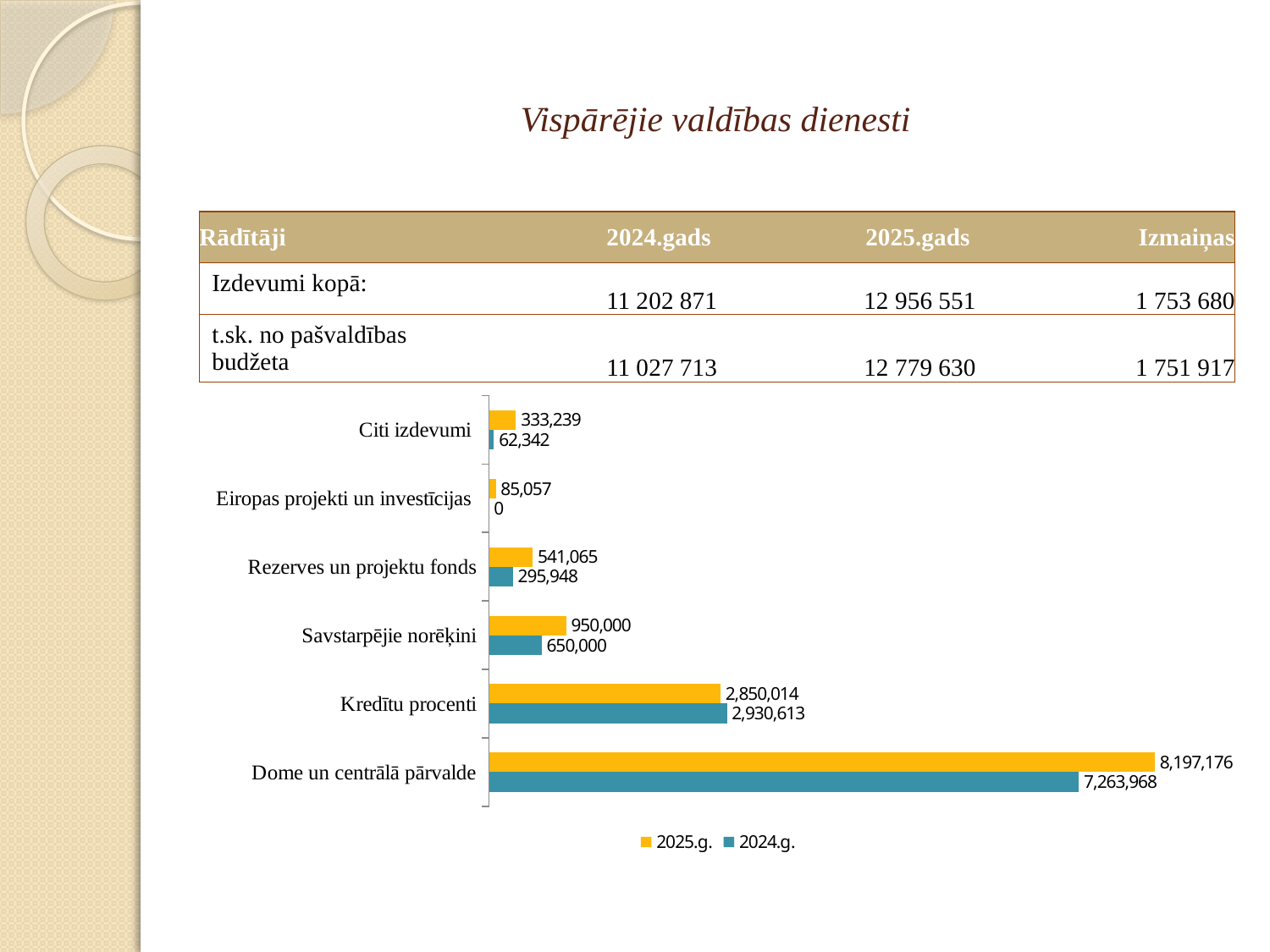
Which category has the lowest 2024.g. value? Eiropas projekti un investīcijas What is the 2025.g. value for Rezerves un projektu fonds? 541,065 What is the 2024.g. value for Kredītu procenti? 2,930,613 For Kredītu procenti, which is larger: the 2025.g. value or the 2024.g. value? 2024.g. Which category has the highest 2025.g. value? Dome un centrālā pārvalde What is the 2025.g. value for Dome un centrālā pārvalde? 8,197,176 What is the difference between the 2025.g. and 2024.g. values for Savstarpējie norēķini? 300,000 How many categories are shown on the chart? 6 What is the 2024.g. value for Eiropas projekti un investīcijas? 0 What kind of chart is shown on the slide? Bar chart How many series does the legend list? 2 What is the difference between the 2025.g. and 2024.g. values for Dome un centrālā pārvalde? 933,208